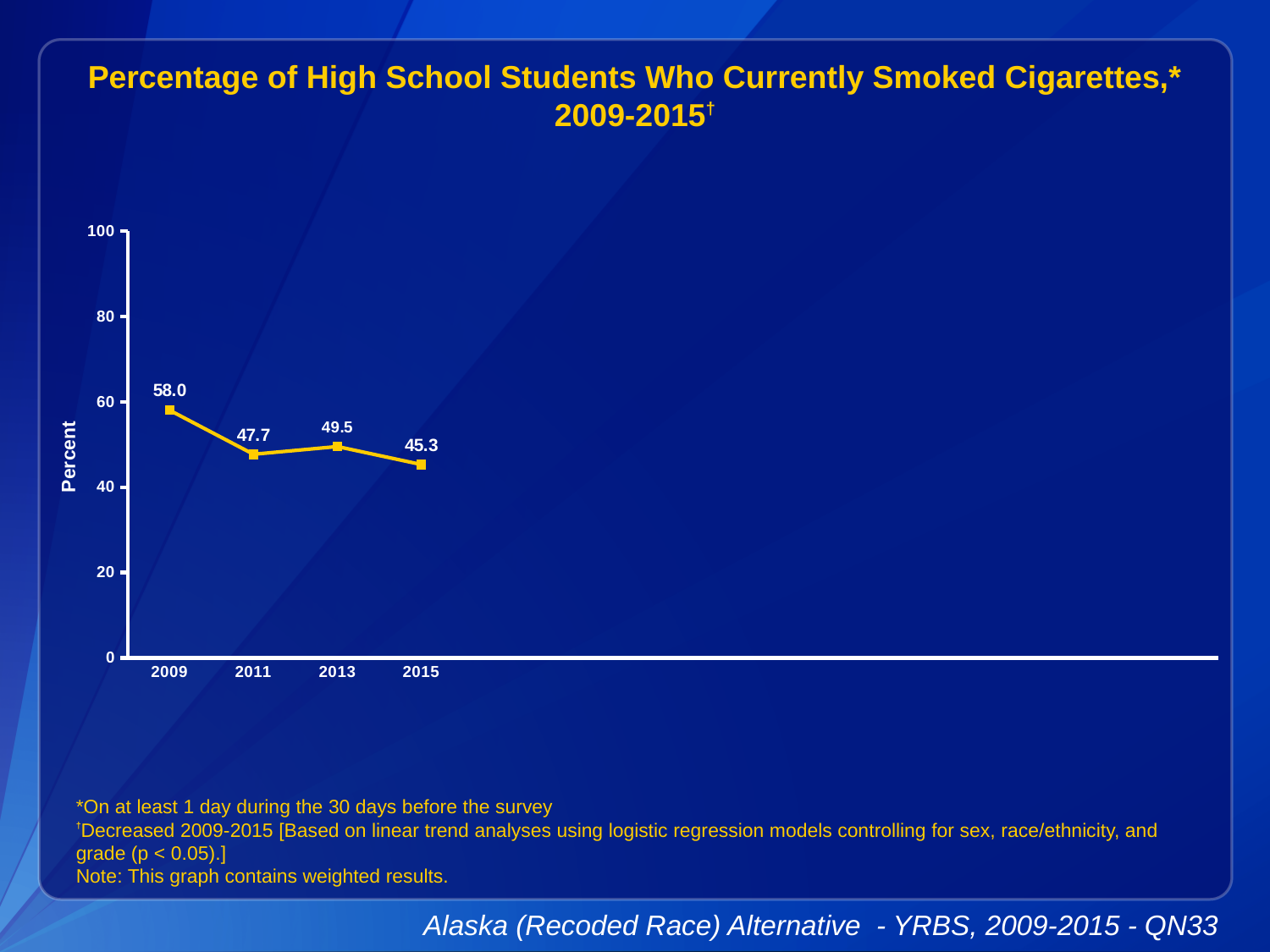
What percentage of high school students currently smoked cigarettes in 2009? 58.0 Which year has the highest percentage? 2009 What is the label on the vertical axis? Percent What is the value plotted for 2013? 49.5 What is the difference between the 2009 value and the 2015 value? 12.7 Which is larger, the value for 2011 or the value for 2013? 2013 What kind of chart is shown on the slide? line chart Is the value for 2009 greater or less than 60? less How many years are plotted on the chart? 4 What is the difference between the 2013 value and the 2011 value? 1.8 What is the value plotted for 2015? 45.3 Which year has the lowest percentage? 2015